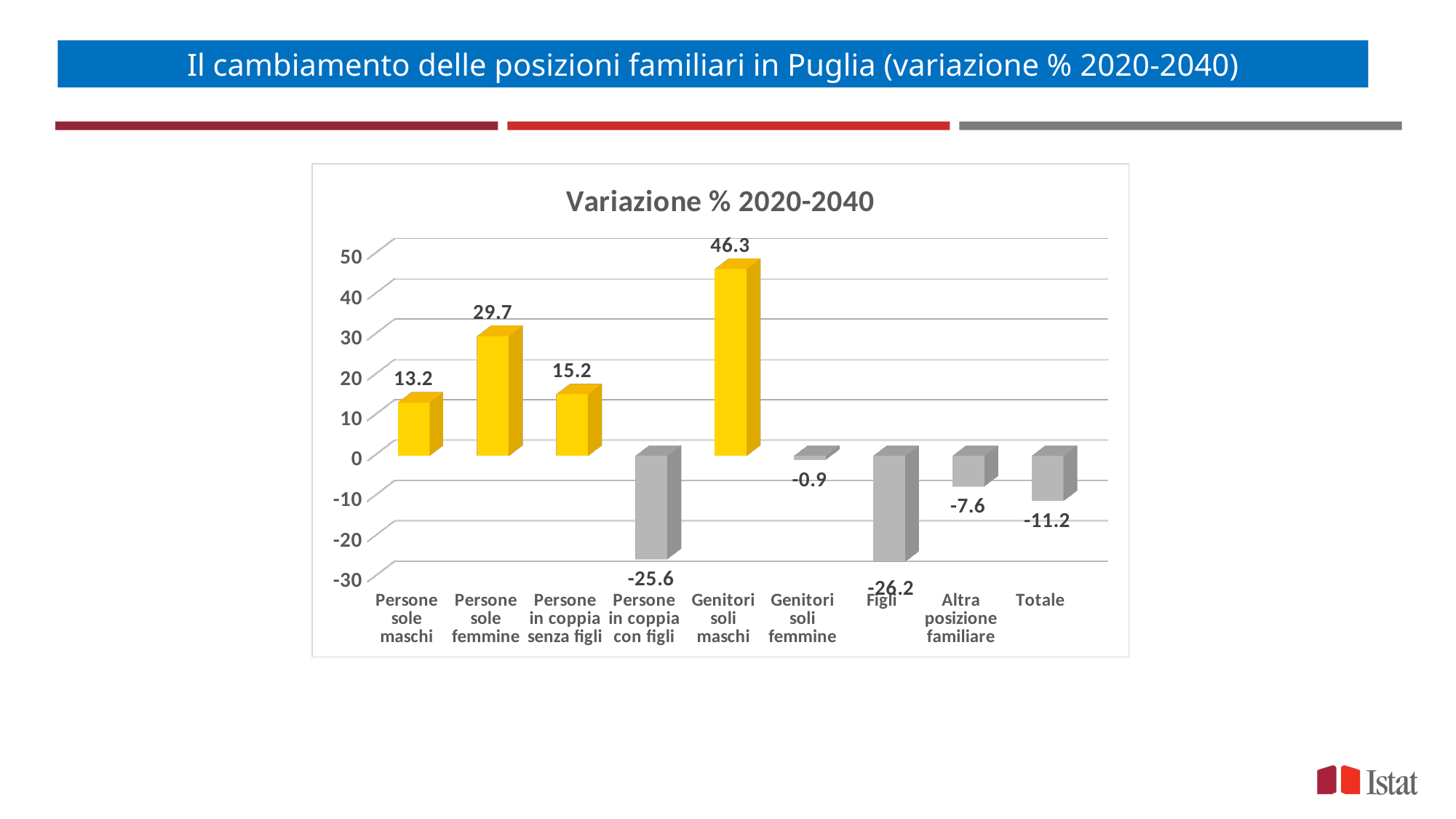
What is the title of the chart? Variazione % 2020-2040 What is the difference between Persone sole femmine and Persone sole maschi? 16.5 How many categories are shown on the x axis? 9 What is the value for Totale? -11.2 What kind of chart is this? Bar chart What is the value for Persone in coppia con figli? -25.6 What colour are the bars with positive values? Yellow What is the value for Genitori soli maschi? 46.3 What is the value for Genitori soli femmine? -0.9 Which is larger, the value for Persone sole femmine or Persone in coppia senza figli? Persone sole femmine Which category has the lowest value? Figli Which category has the highest value? Genitori soli maschi